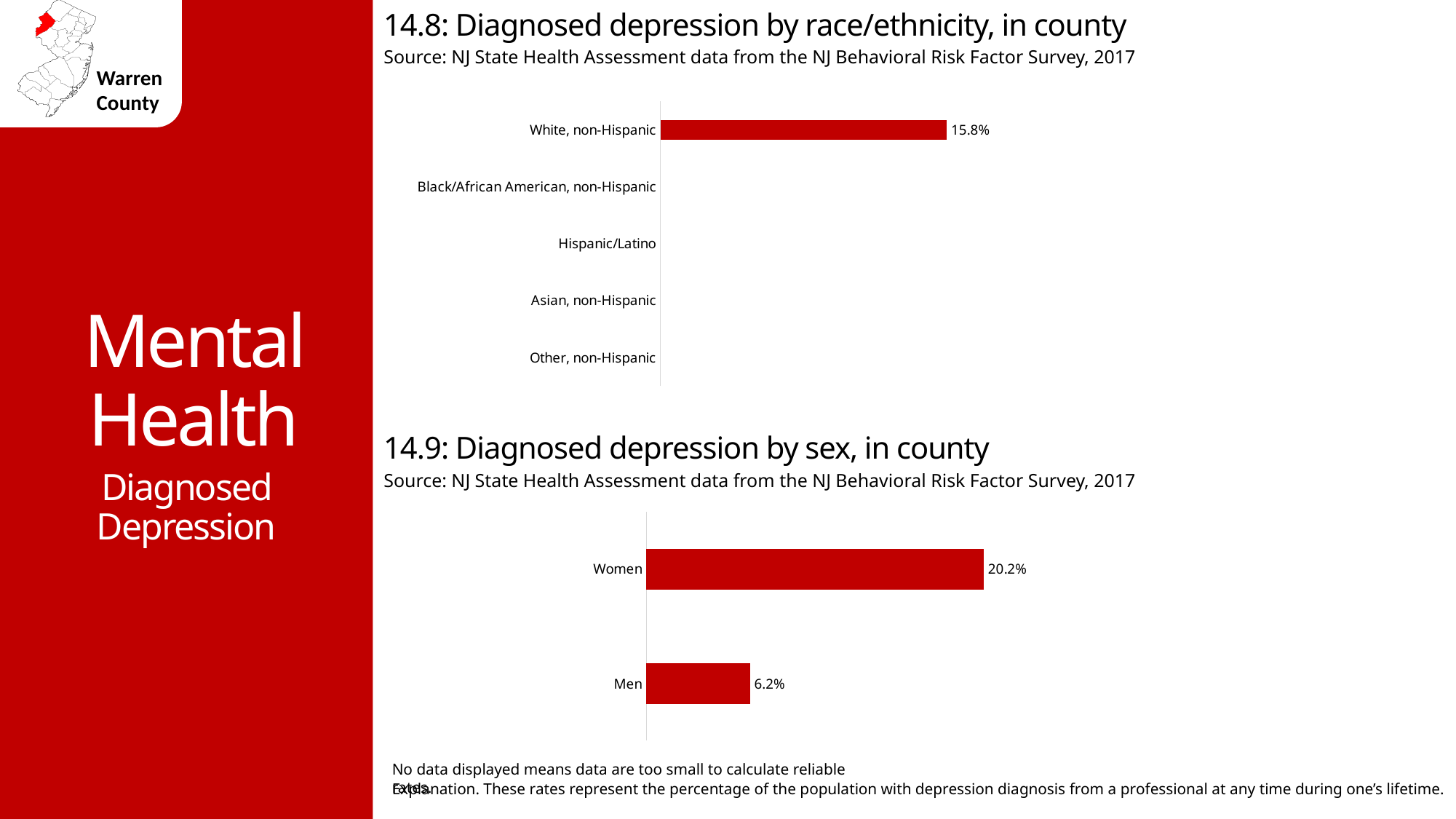
What kind of chart is '14.9: Diagnosed depression by sex, in county'? Bar chart In the chart '14.9: Diagnosed depression by sex, in county', how many categories are shown? 2 In the chart '14.9: Diagnosed depression by sex, in county', what is the difference between the values for Women and Men? 14.0% What kind of chart is '14.8: Diagnosed depression by race/ethnicity, in county'? Bar chart In the chart '14.8: Diagnosed depression by race/ethnicity, in county', which category is the only one with a bar displayed? White, non-Hispanic In the chart '14.9: Diagnosed depression by sex, in county', which category has the lower value? Men In the chart '14.9: Diagnosed depression by sex, in county', what is the value for Women? 20.2% What is the source cited for the chart '14.9: Diagnosed depression by sex, in county'? NJ State Health Assessment data from the NJ Behavioral Risk Factor Survey, 2017 In the chart '14.8: Diagnosed depression by race/ethnicity, in county', what is the value for White, non-Hispanic? 15.8% In the chart '14.9: Diagnosed depression by sex, in county', what is the value for Men? 6.2% In the chart '14.8: Diagnosed depression by race/ethnicity, in county', how many race/ethnicity categories are listed on the axis? 5 In the chart '14.9: Diagnosed depression by sex, in county', which category has the higher value? Women